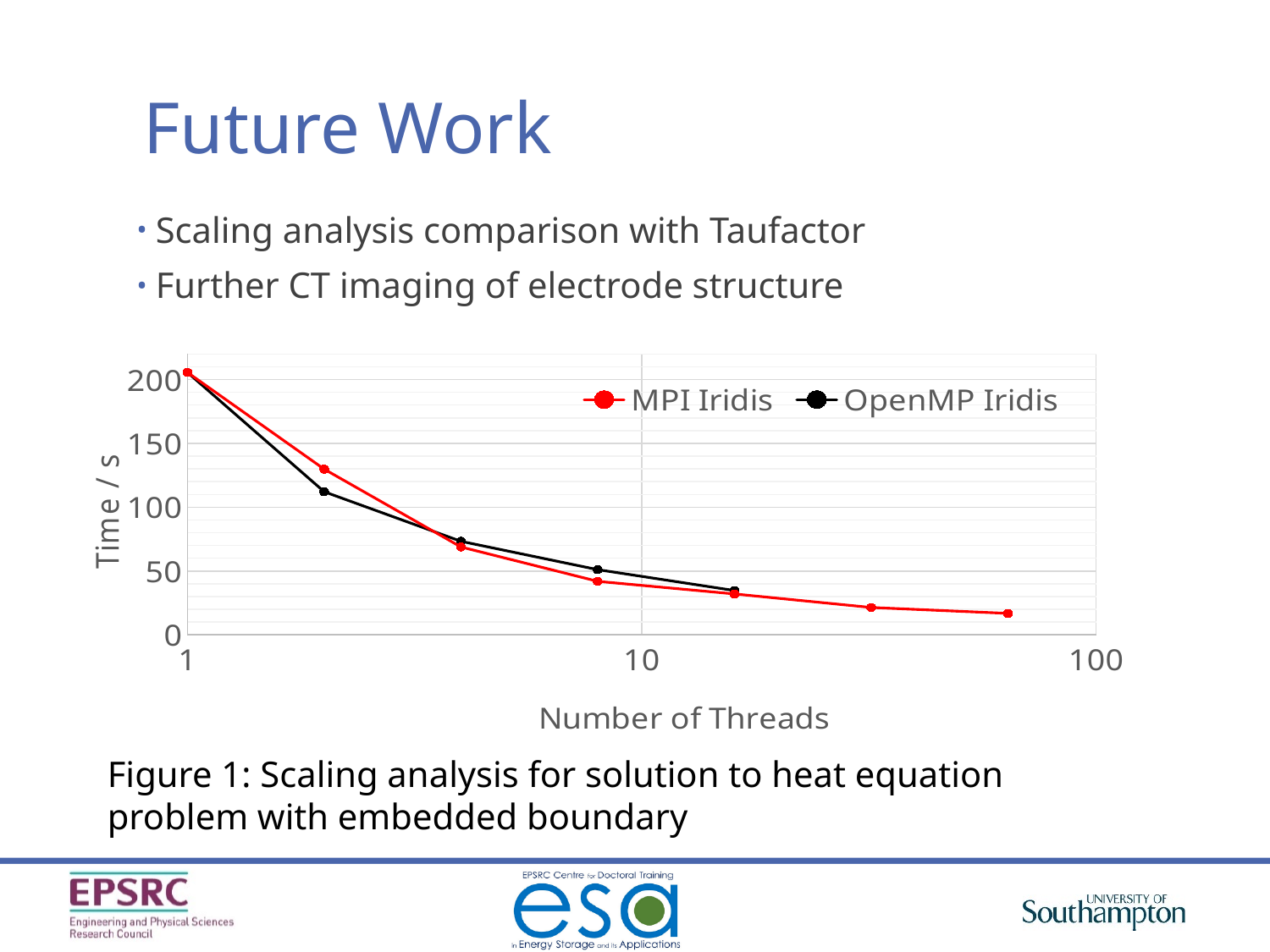
Is the value for MPI Iridis at its rightmost point (around 64 threads) greater or less than 50? less At 2 threads, which series has the higher time: MPI Iridis or OpenMP Iridis? MPI Iridis How many data points are plotted for the MPI Iridis series? 7 How many series does the chart legend list? 2 What kind of chart is shown on the slide? line chart Do the values for MPI Iridis rise or fall as the number of threads increases? fall What is the y-axis title of the chart? Time / s Is the value for MPI Iridis at 1 thread greater or less than 150? greater Is the value for OpenMP Iridis at 2 threads greater or less than 100? greater Do the values for OpenMP Iridis rise or fall as the number of threads increases? fall What are the two series named in the chart legend? MPI Iridis and OpenMP Iridis How many data points are plotted for the OpenMP Iridis series? 5